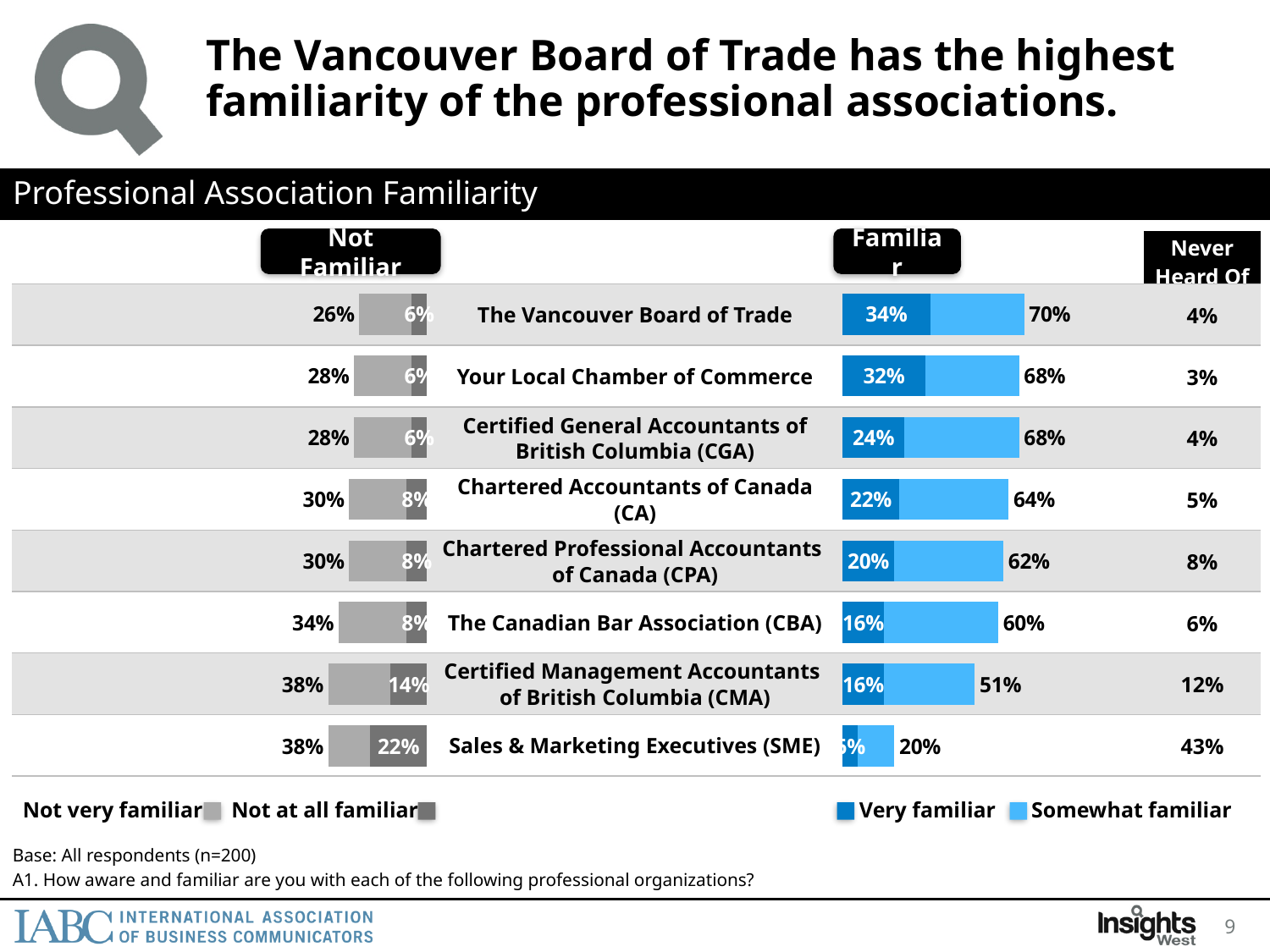
What is the difference between the Familiar percentages for The Vancouver Board of Trade and The Canadian Bar Association (CBA)? 10% How many professional associations are listed in the chart? 8 Which professional association has the highest Never Heard Of percentage? Sales & Marketing Executives (SME) What is the Very familiar percentage shown for Your Local Chamber of Commerce? 32% What is the Never Heard Of percentage for Sales & Marketing Executives (SME)? 43% Which professional association has the lowest Familiar percentage? Sales & Marketing Executives (SME) What is the Not Familiar percentage shown for Certified Management Accountants of British Columbia (CMA)? 38% Which has a higher Very familiar percentage: Certified General Accountants of British Columbia (CGA) or Chartered Accountants of Canada (CA)? Certified General Accountants of British Columbia (CGA) What is the Not at all familiar percentage shown for Sales & Marketing Executives (SME)? 22% What type of chart is used to show Professional Association Familiarity? Bar chart Which professional association has the highest Familiar percentage? The Vancouver Board of Trade What is the Familiar percentage shown for The Vancouver Board of Trade? 70%